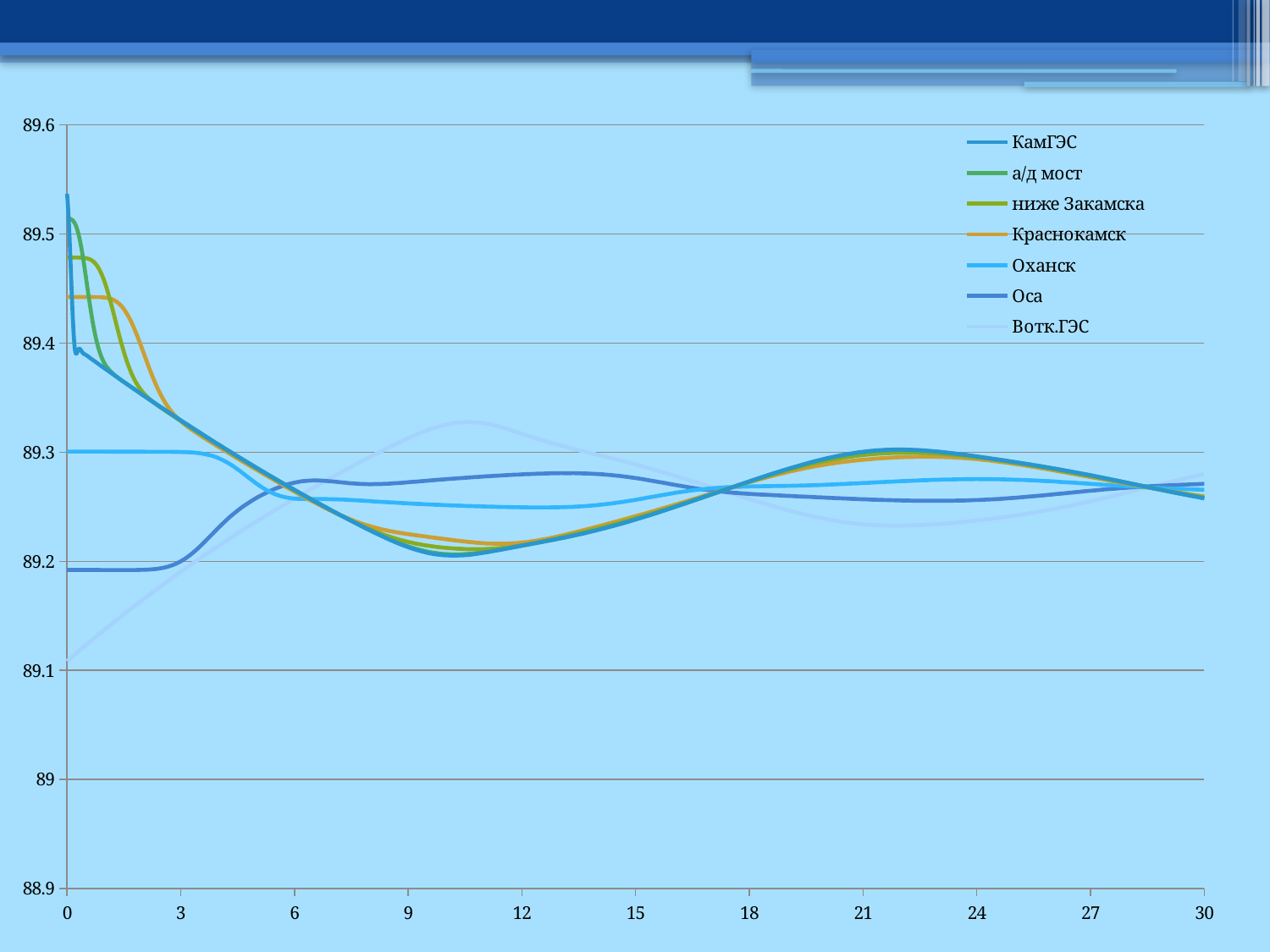
Which series has the lowest value at x = 0? Вотк.ГЭС Which series is listed last in the legend? Вотк.ГЭС Is the value of Вотк.ГЭС at x = 0 greater or less than 89.2? less Does the КамГЭС series overall rise or fall from x = 0 to x = 30? fall How many series does the legend list? 7 Is the value of Оса at x = 30 greater or less than 89.3? less Which series has the highest value at x = 0? КамГЭС What kind of chart is shown on the slide? line chart Is the value of Краснокамск at x = 0 greater or less than 89.4? greater At x = 0, which is larger: the value of Оханск or the value of Оса? Оханск Does the Оса series overall rise or fall from x = 0 to x = 30? rise